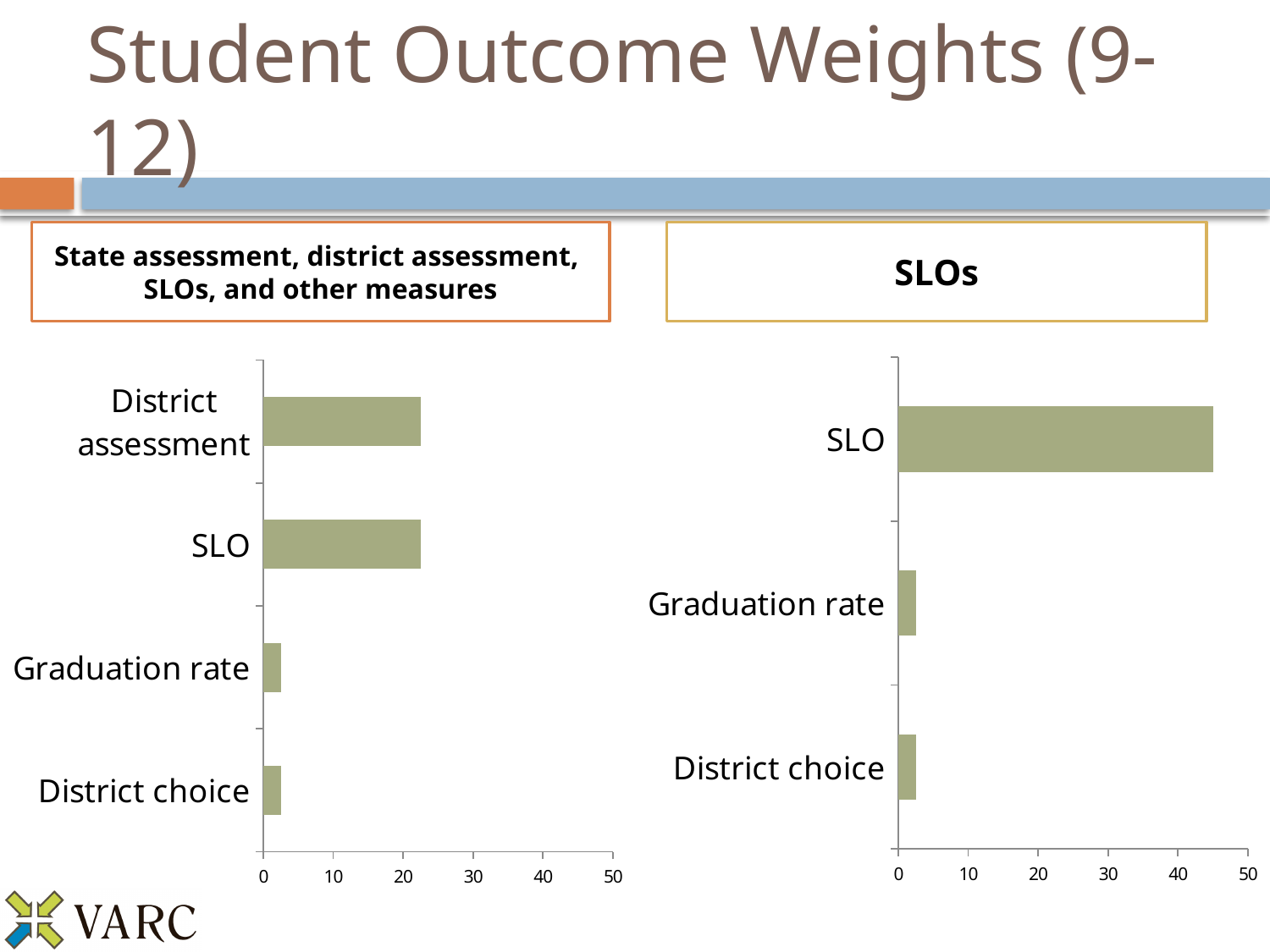
How many categories does the left chart show? 4 In the left chart, is the value for SLO greater or less than 30? less What is the title shown above the right chart? SLOs What kind of chart is the left chart on the slide? bar chart In the right chart (SLOs), which category has the highest value? SLO In the right chart (SLOs), is the value for District choice greater or less than 10? less How many categories does the right chart (SLOs) show? 3 In the left chart, which is larger: District assessment or Graduation rate? District assessment In the left chart, is the value for Graduation rate greater or less than 10? less In the right chart (SLOs), which is larger: SLO or District choice? SLO